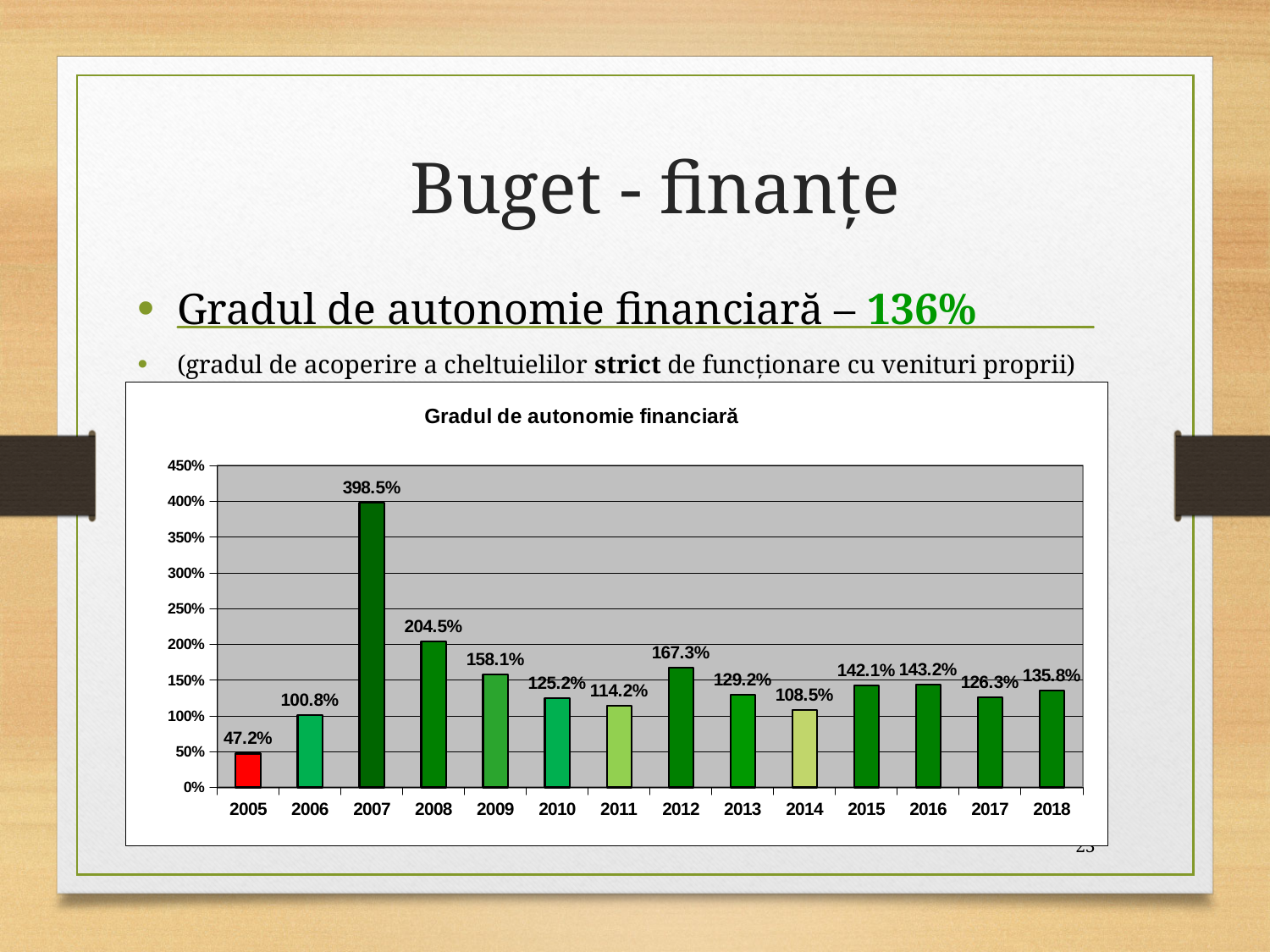
Is the value for 2009 greater or less than 150%? greater How many years are shown on the x axis of the chart? 14 Which is larger, the value for 2012 or the value for 2013? 2012 What is the difference between the values for 2007 and 2008? 194.0% What is the value for 2005 in the chart? 47.2% What is the value for 2007 in the chart? 398.5% What is the value for 2014 in the chart? 108.5% Which year has the lowest value in the chart? 2005 What is the title of the chart? Gradul de autonomie financiară What kind of chart is shown on the slide? bar chart Which year has the highest value in the chart? 2007